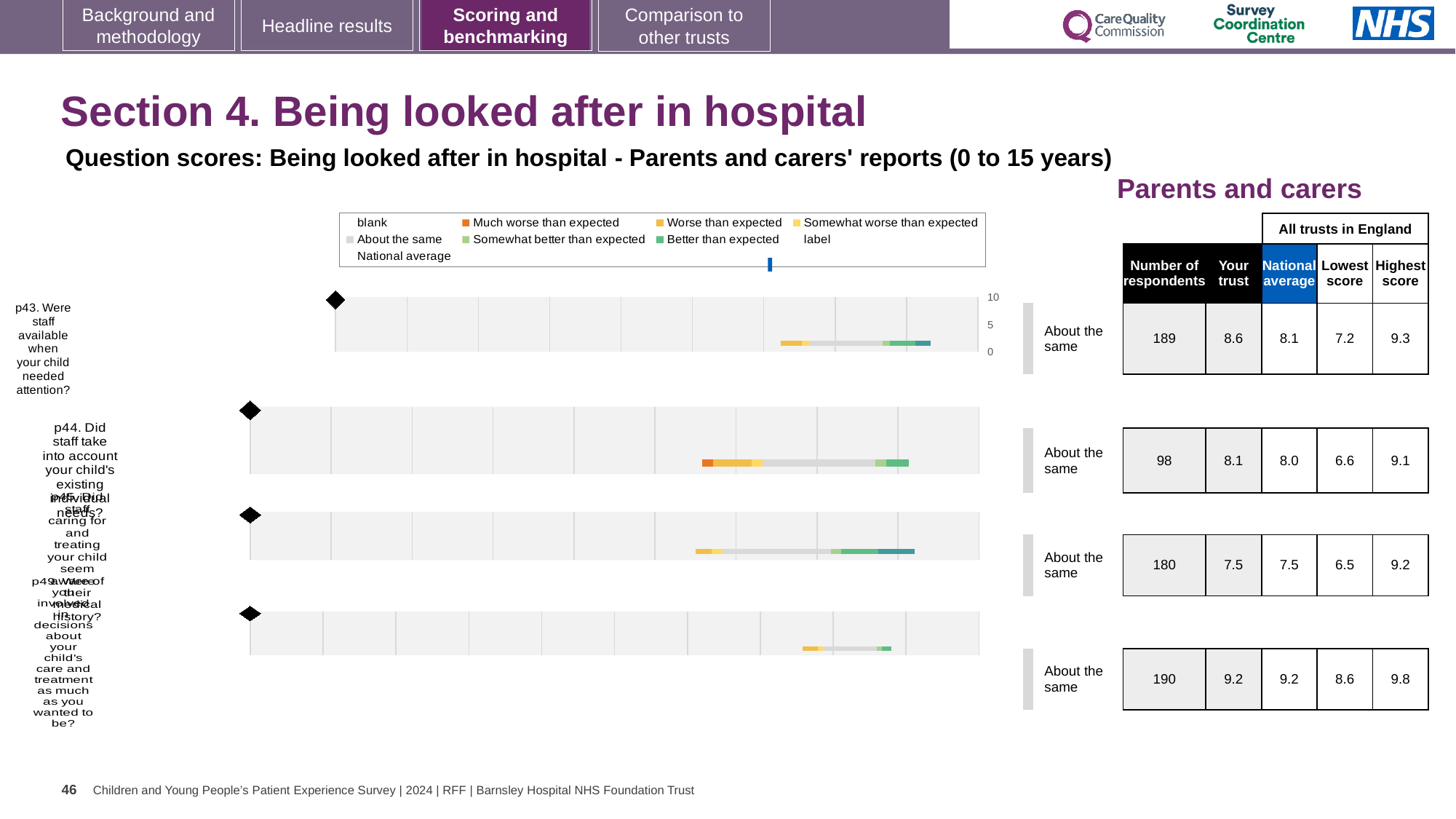
What benchmark category is shown next to the top chart (p43)? About the same What kind of chart is used to show the score for question p43 (the top chart)? bar chart How many question charts are shown on the slide? 4 How many respondents are listed for the top chart (p43)? 189 For the top chart (p43), what is the difference between the 'Your trust' score and the national average? 0.5 Which of the four question charts has the highest 'Your trust' score? The bottom chart (p49), 9.2 For the second chart from the top (p44), what is the highest score among all trusts in England? 9.1 For the top chart (p43, staff available when your child needed attention), what is the 'Your trust' score shown in the table? 8.6 For the top chart (p43), what is the national average score? 8.1 For the third chart from the top (p45), what is the lowest score among all trusts in England? 6.5 Which of the four question charts has the lowest 'Your trust' score? The third chart (p45), 7.5 For the second chart from the top (p44), which is larger: the 'Your trust' score or the national average? Your trust